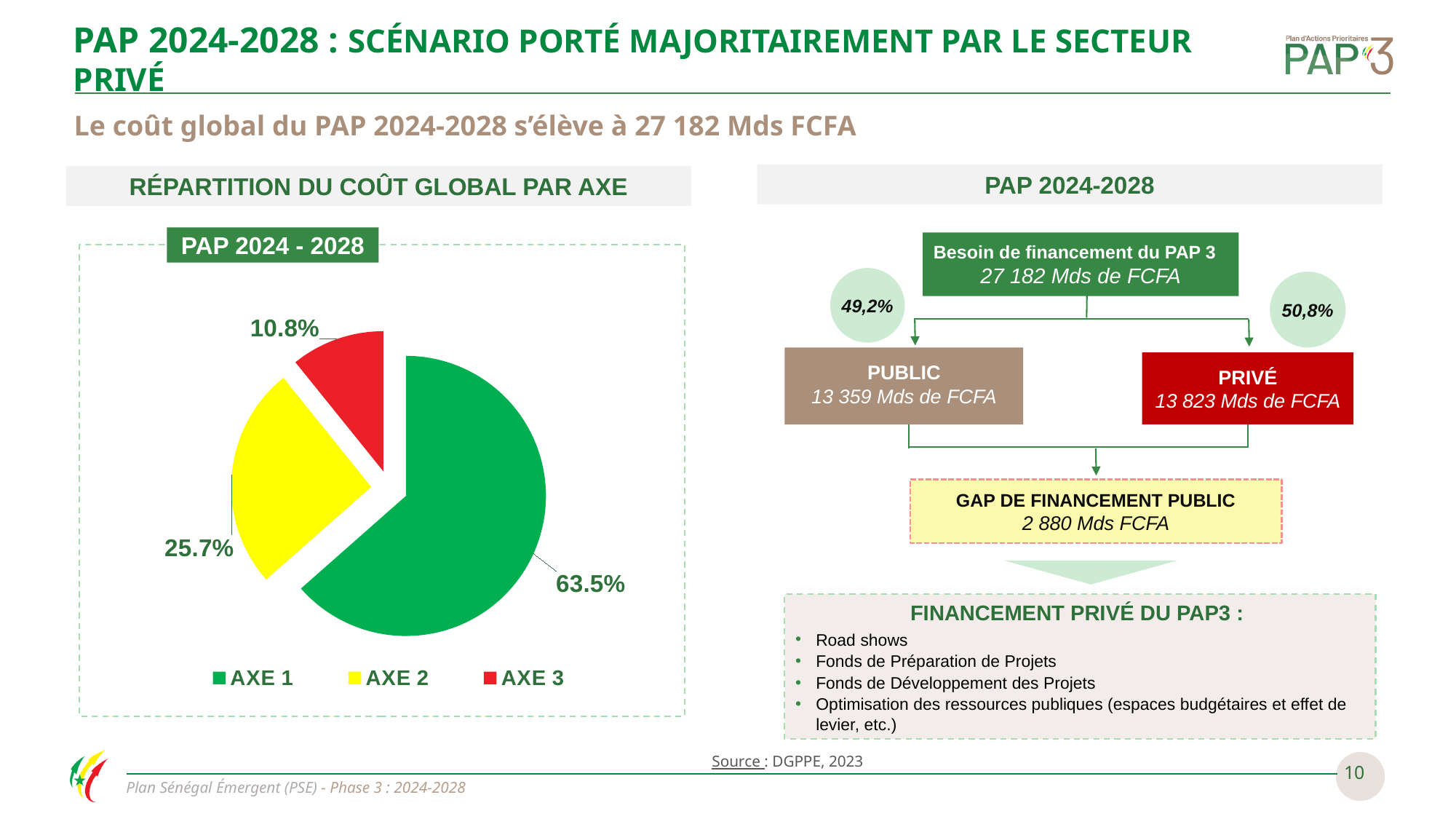
What share of the pie chart does AXE 3 represent? 10.8% What type of chart is shown under 'RÉPARTITION DU COÛT GLOBAL PAR AXE'? Pie chart What share of the pie chart does AXE 1 represent? 63.5% How many entries does the pie chart legend list? 3 What is the difference in percentage points between the AXE 1 and AXE 2 slices? 37.8 What is the difference in percentage points between the AXE 2 and AXE 3 slices? 14.9 Which slice is larger in the pie chart, AXE 2 or AXE 3? AXE 2 How many slices does the pie chart have? 3 What share of the pie chart does AXE 2 represent? 25.7% What colour is the AXE 3 slice in the pie chart? Red Which axe has the smallest slice in the pie chart? AXE 3 Which axe has the largest slice in the pie chart? AXE 1